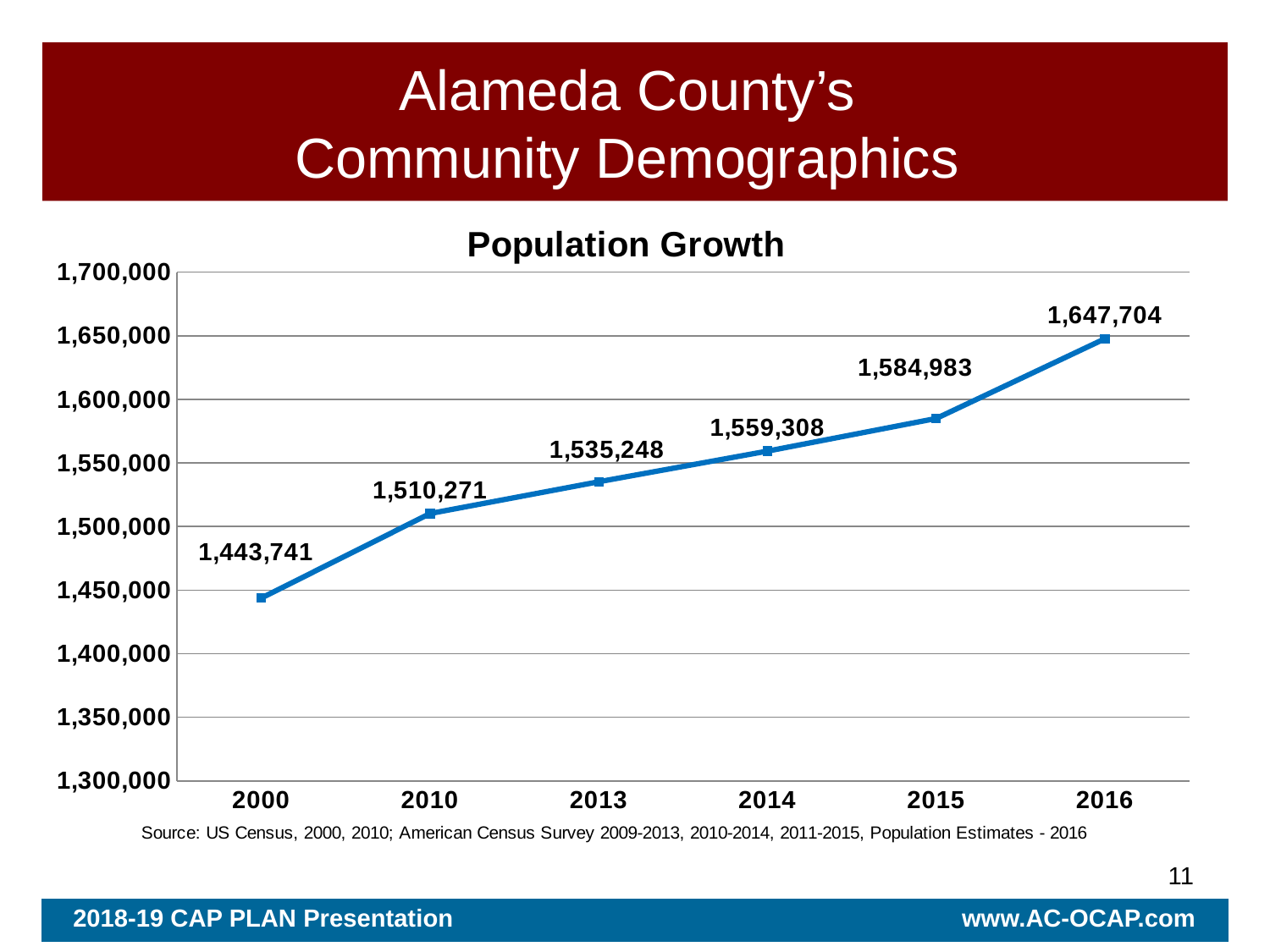
What kind of chart is shown? line chart What is the population value shown for 2000? 1,443,741 Which year has the lowest population value? 2000 Which year has the highest population value? 2016 Is the value for 2015 greater or less than 1,600,000? less What is the population value shown for 2016? 1,647,704 What is the difference between the population in 2016 and in 2015? 62,721 Which is larger, the population in 2014 or in 2013? 2014 Do the values rise or fall from 2000 to 2016? rise How many years are plotted on the chart? 6 What is the population value shown for 2013? 1,535,248 What is the difference between the population in 2010 and in 2000? 66,530